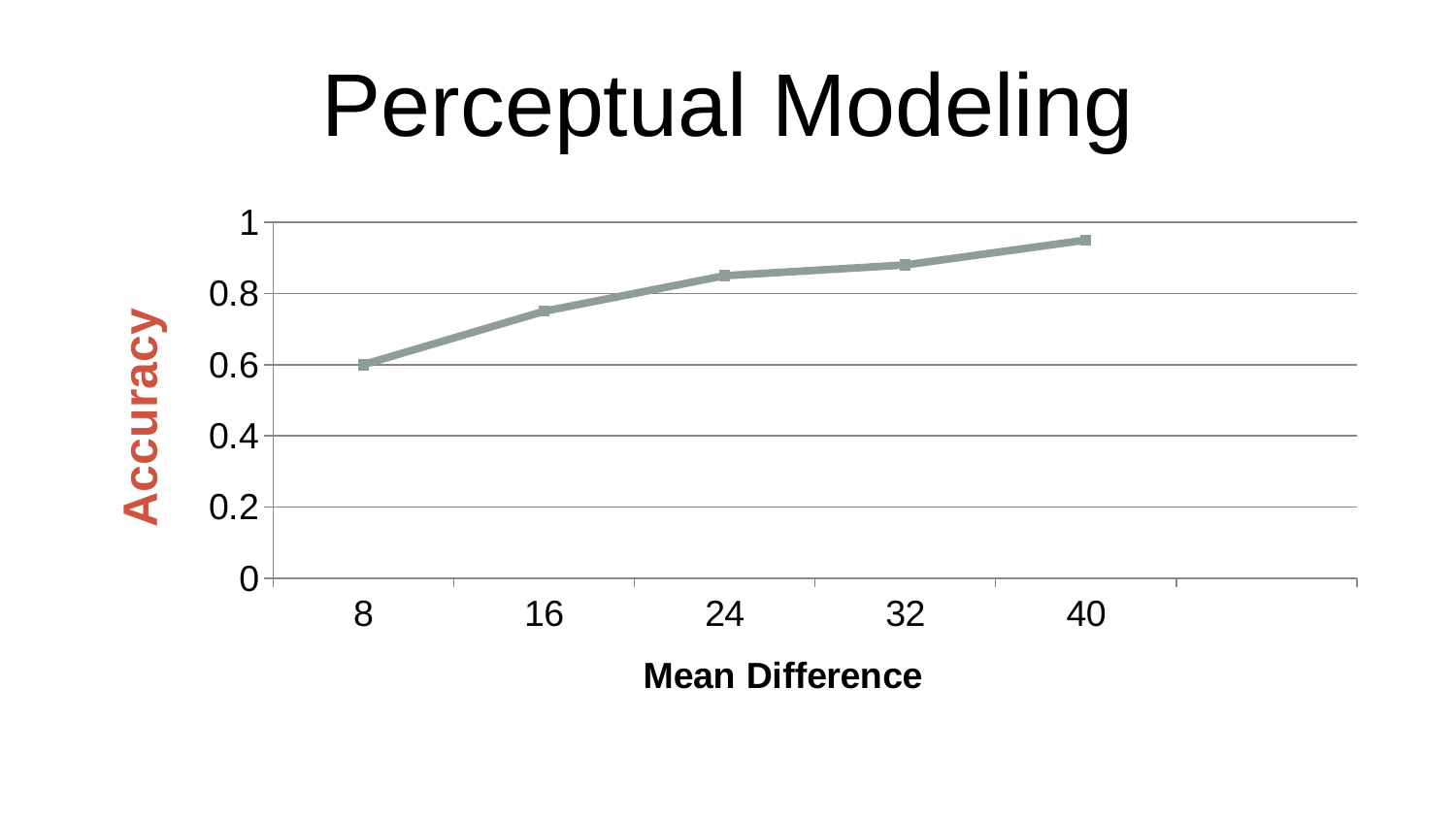
Does accuracy rise or fall as mean difference increases along the x axis? rise At which mean difference is accuracy highest? 40 Is the accuracy value at a mean difference of 24 greater or less than 0.8? greater What type of chart is shown on the slide? line chart How many data points are plotted on the line? 5 Is the accuracy value at a mean difference of 40 greater or less than 0.8? greater What is the accuracy value at a mean difference of 8? 0.6 At which mean difference is accuracy lowest? 8 What is the label on the x axis of the chart? Mean Difference What is the label on the y axis of the chart? Accuracy Is the accuracy value at a mean difference of 16 greater or less than 0.8? less Which has the higher accuracy: a mean difference of 16 or a mean difference of 32? 32